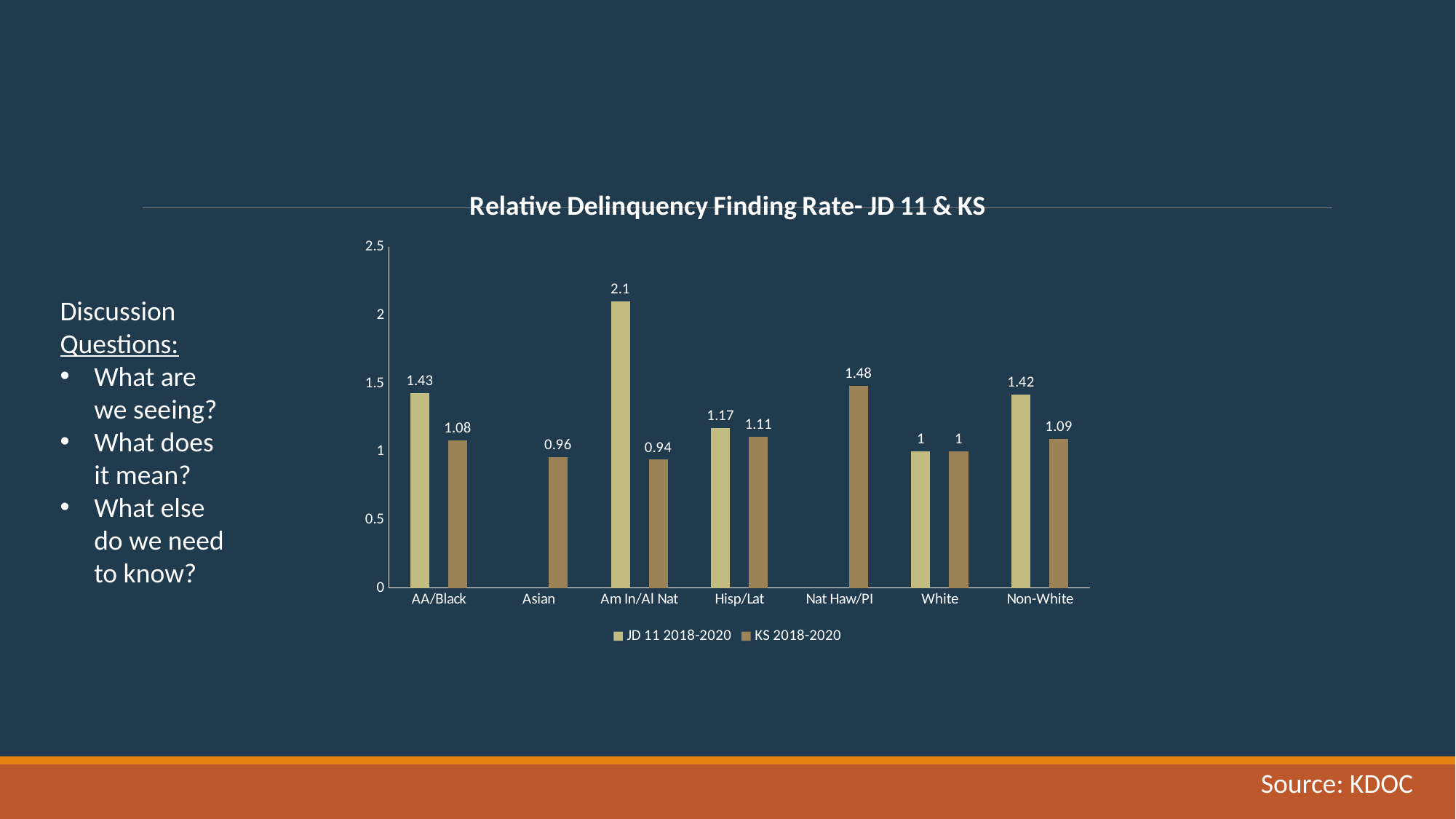
Which category has the lowest KS 2018-2020 value? Am In/Al Nat What is the KS 2018-2020 value for Am In/Al Nat? 0.94 What is the title of the chart? Relative Delinquency Finding Rate- JD 11 & KS Which category has the highest JD 11 2018-2020 value? Am In/Al Nat How many series does the legend list? 2 What is the difference between the JD 11 2018-2020 and KS 2018-2020 values for Am In/Al Nat? 1.16 What is the JD 11 2018-2020 value for AA/Black? 1.43 How many categories are shown on the x axis? 7 What is the KS 2018-2020 value for Nat Haw/PI? 1.48 Is the JD 11 2018-2020 value for Am In/Al Nat greater or less than 2? greater Which is larger for Hisp/Lat: the JD 11 2018-2020 value or the KS 2018-2020 value? JD 11 2018-2020 What kind of chart is shown on the slide? Bar chart